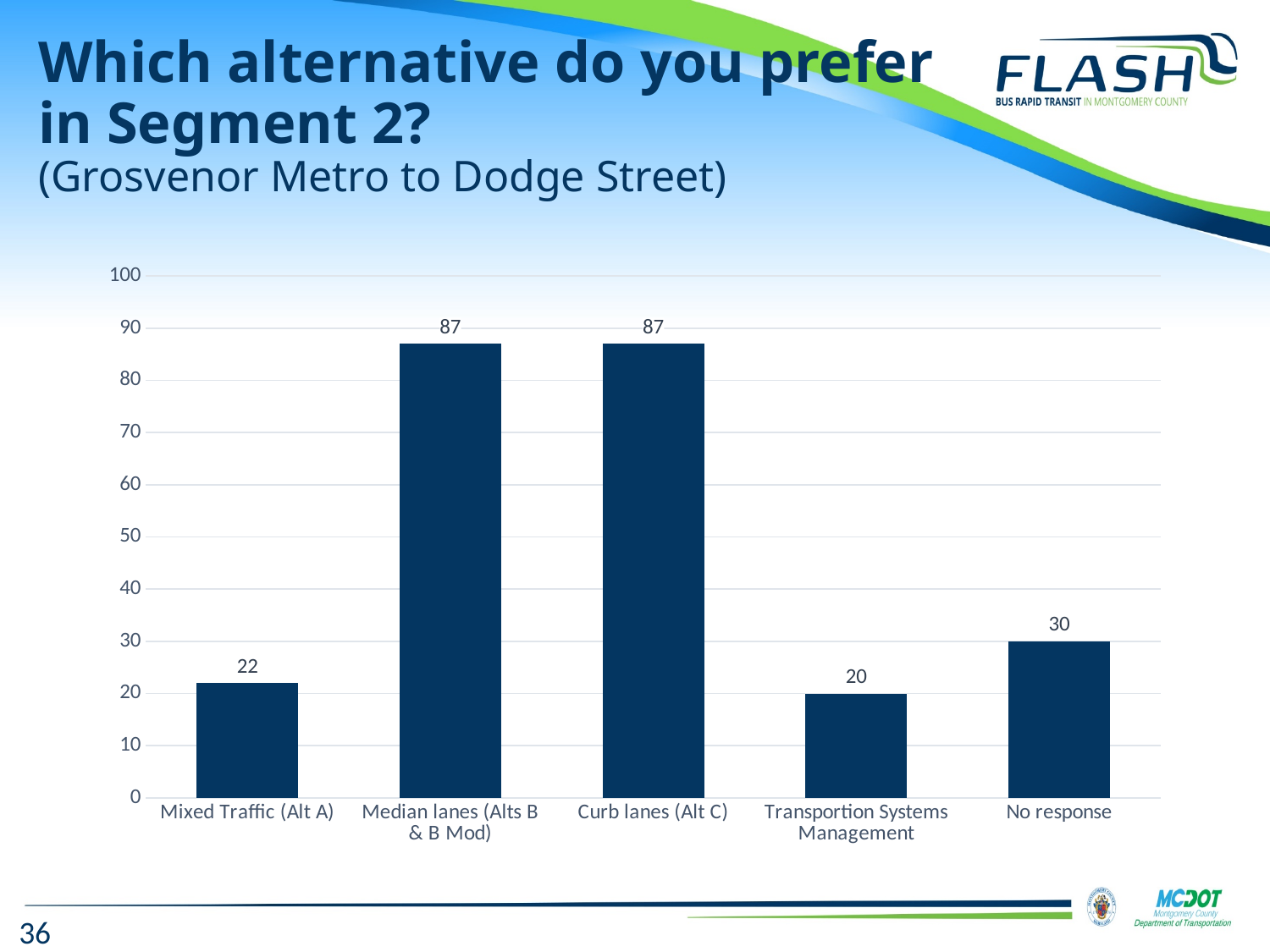
What is the difference between the values for Mixed Traffic (Alt A) and Transportion Systems Management? 2 What is the value for Curb lanes (Alt C)? 87 Which category has the lowest value? Transportion Systems Management What kind of chart is shown on the slide? bar chart What is the value for No response? 30 Which is larger, the value for No response or the value for Mixed Traffic (Alt A)? No response Is the value for Median lanes (Alts B & B Mod) greater or less than 80? greater What is the value for Mixed Traffic (Alt A)? 22 How many categories are shown on the x axis? 5 What is the value for Transportion Systems Management? 20 What is the difference between the values for Curb lanes (Alt C) and No response? 57 What is the value for Median lanes (Alts B & B Mod)? 87